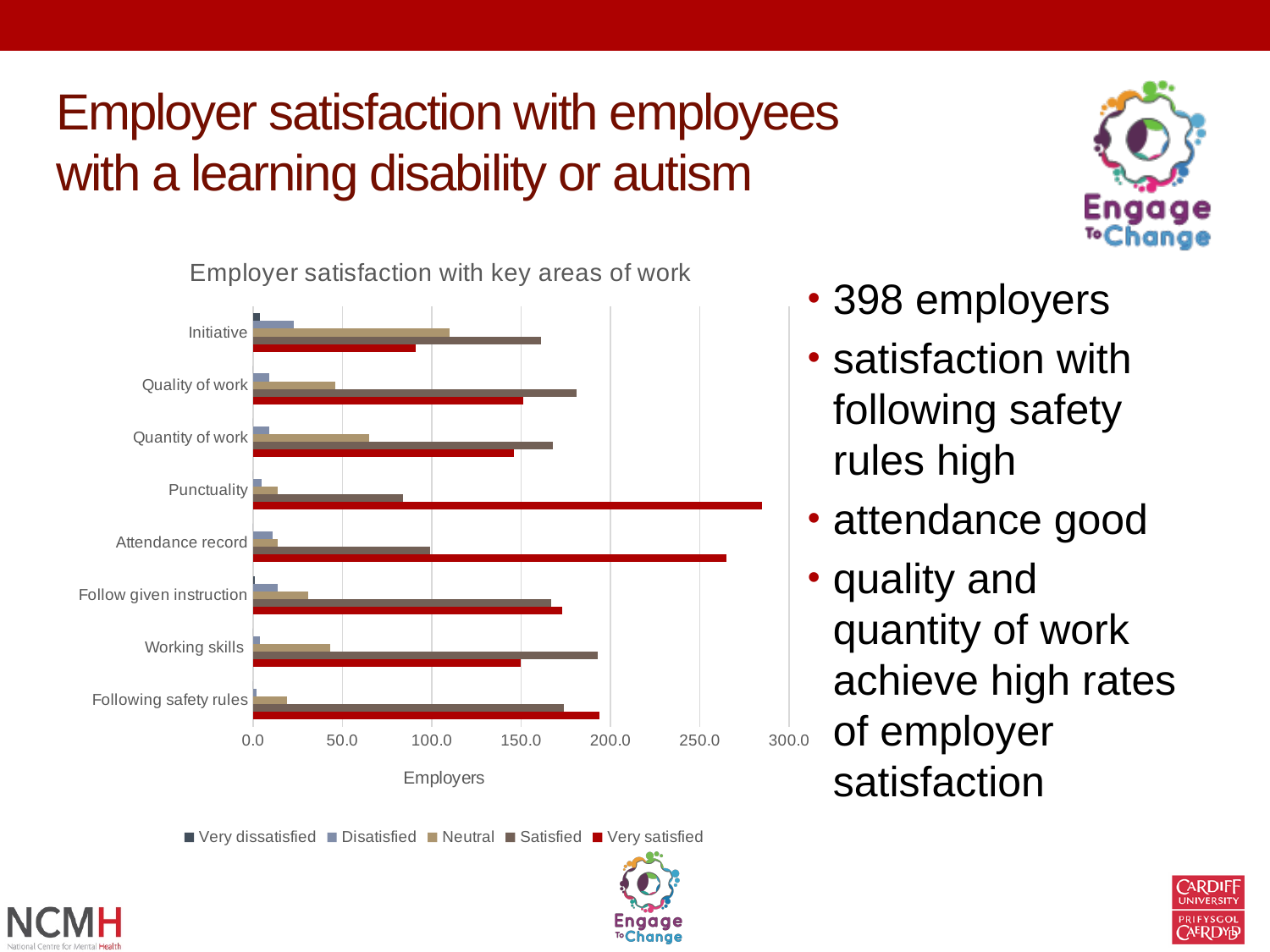
How many series does the chart legend list? 5 Which has the larger Satisfied value: Working skills or Punctuality? Working skills What kind of chart is shown on the slide? bar chart What is the label on the horizontal axis of the chart? Employers Is the Satisfied value for Working skills greater or less than 150.0? greater Is the Very satisfied value for Initiative greater or less than 100.0? less How many categories (areas of work) are shown on the chart? 8 Which category has the highest Very satisfied value? Punctuality Is the Neutral value for Following safety rules greater or less than 50.0? less Which category has the lowest Very satisfied value? Initiative What is the title of the chart? Employer satisfaction with key areas of work